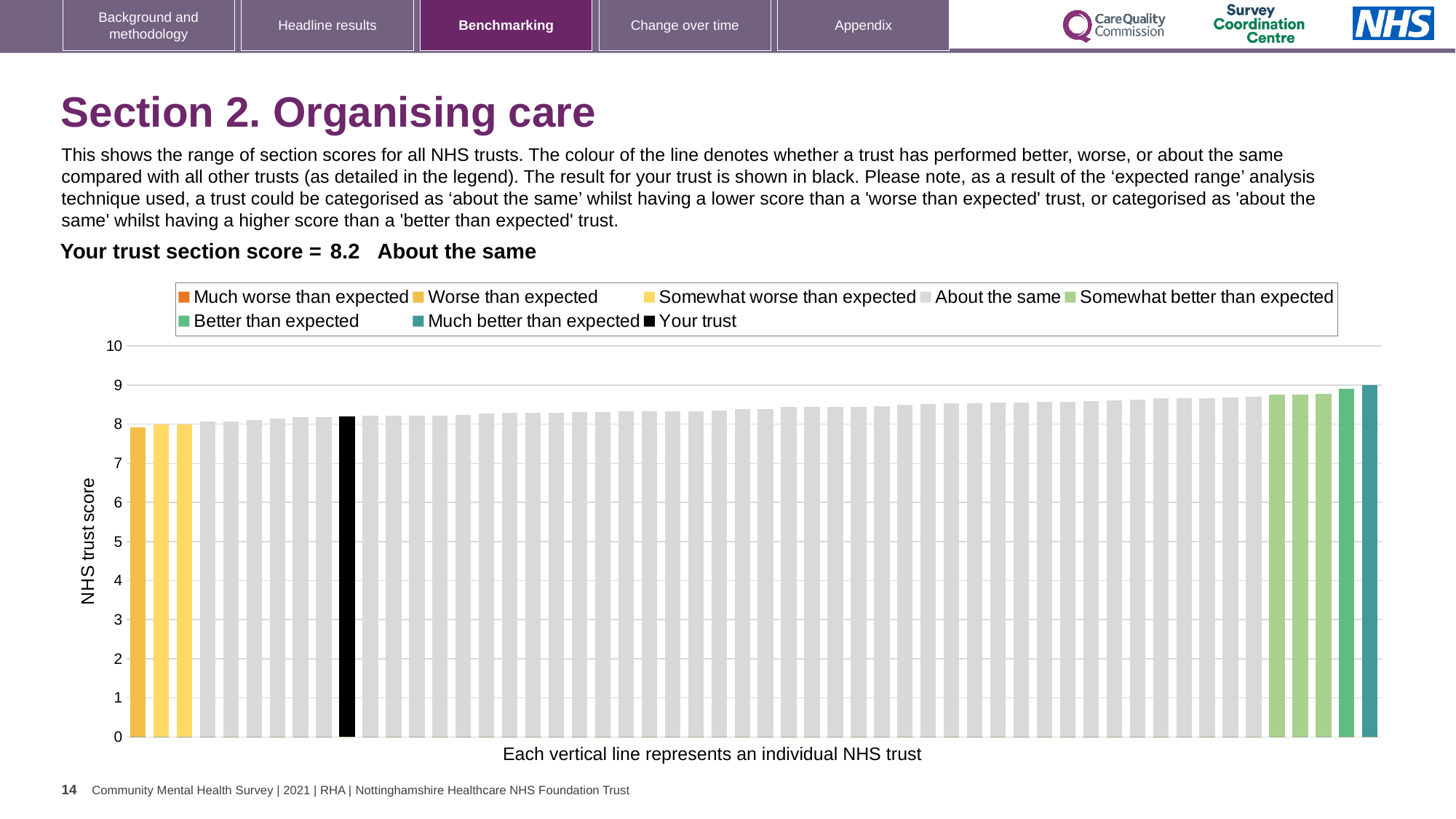
Is the value for your trust (the black bar) greater or less than 8? greater Which legend category does the tallest bar in the chart belong to? Much better than expected Which category is your trust placed in according to the text above the chart? About the same Is the value for the lowest bar in the chart greater or less than 7? greater What is the section score for your trust shown on the slide? 8.2 What is the title of the vertical axis? NHS trust score Do the bar values rise or fall from left to right along the x axis? rise What colour is the bar representing your trust? black What kind of chart is shown on the slide? bar chart How many entries does the chart legend list? 8 Is the value for the tallest bar in the chart greater or less than 8? greater